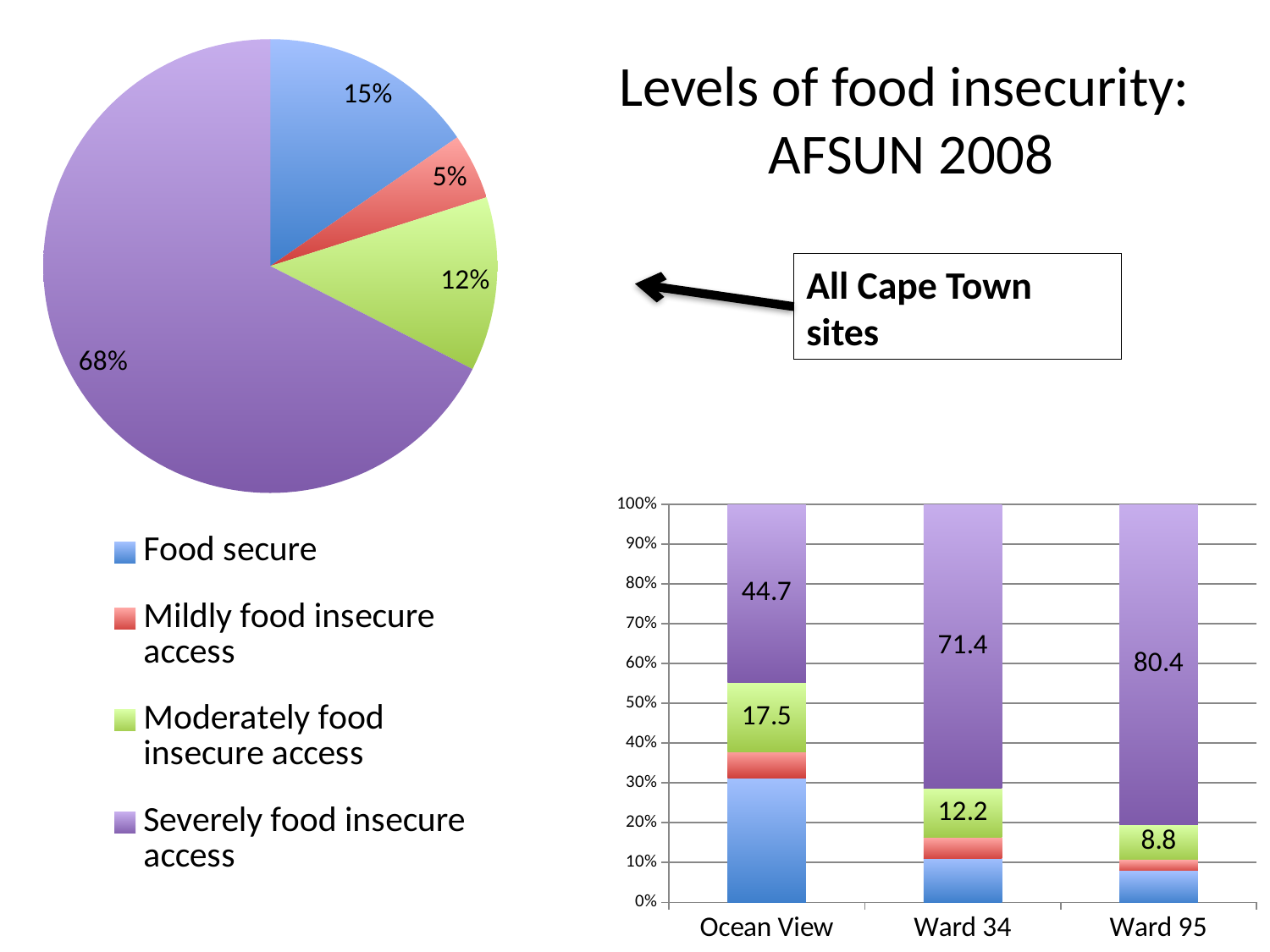
In the pie chart on the left, what share is labelled for the Mildly food insecure access slice? 5% How many sites are shown on the x axis of the stacked bar chart? 3 In the stacked bar chart, what is the labelled value of the green (Moderately food insecure access) segment for Ocean View? 17.5 In the stacked bar chart, what is the difference between the purple (Severely food insecure access) values for Ward 34 and Ocean View? 26.7 What kind of chart is shown in the bottom right of the slide? Stacked bar chart In the pie chart on the left, what share is labelled for the Food secure slice? 15% In the pie chart on the left, which category has the largest slice? Severely food insecure access In the pie chart on the left, what share is labelled for the Severely food insecure access slice? 68% In the pie chart on the left, which category has the smallest slice? Mildly food insecure access In the stacked bar chart, what is the labelled value of the purple (Severely food insecure access) segment for Ward 95? 80.4 In the stacked bar chart, which site has the highest labelled value for the purple (Severely food insecure access) segment? Ward 95 How many categories does the legend of the pie chart on the left list? 4